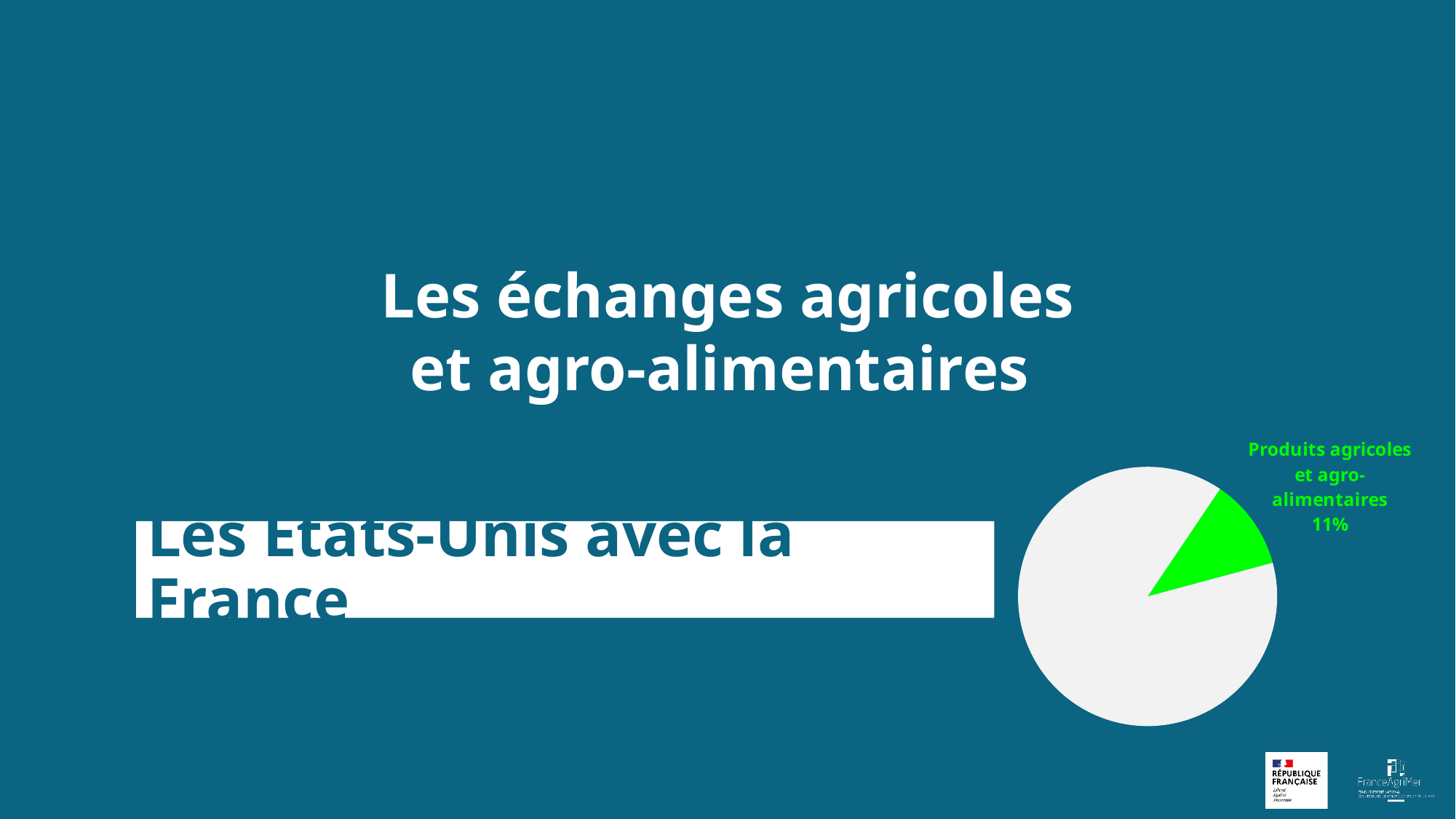
What value is printed next to the green slice of the pie chart? 11% What colour is the slice labelled "Produits agricoles et agro-alimentaires"? green How many slices does the pie chart have? 2 What share of the pie does the slice labelled "Produits agricoles et agro-alimentaires" represent? 11% Is the "Produits agricoles et agro-alimentaires" slice larger or smaller than the grey slice? smaller What kind of chart is shown on the slide? pie chart What is the label of the only labelled slice in the pie chart? Produits agricoles et agro-alimentaires Which slice of the pie chart is the smallest? Produits agricoles et agro-alimentaires